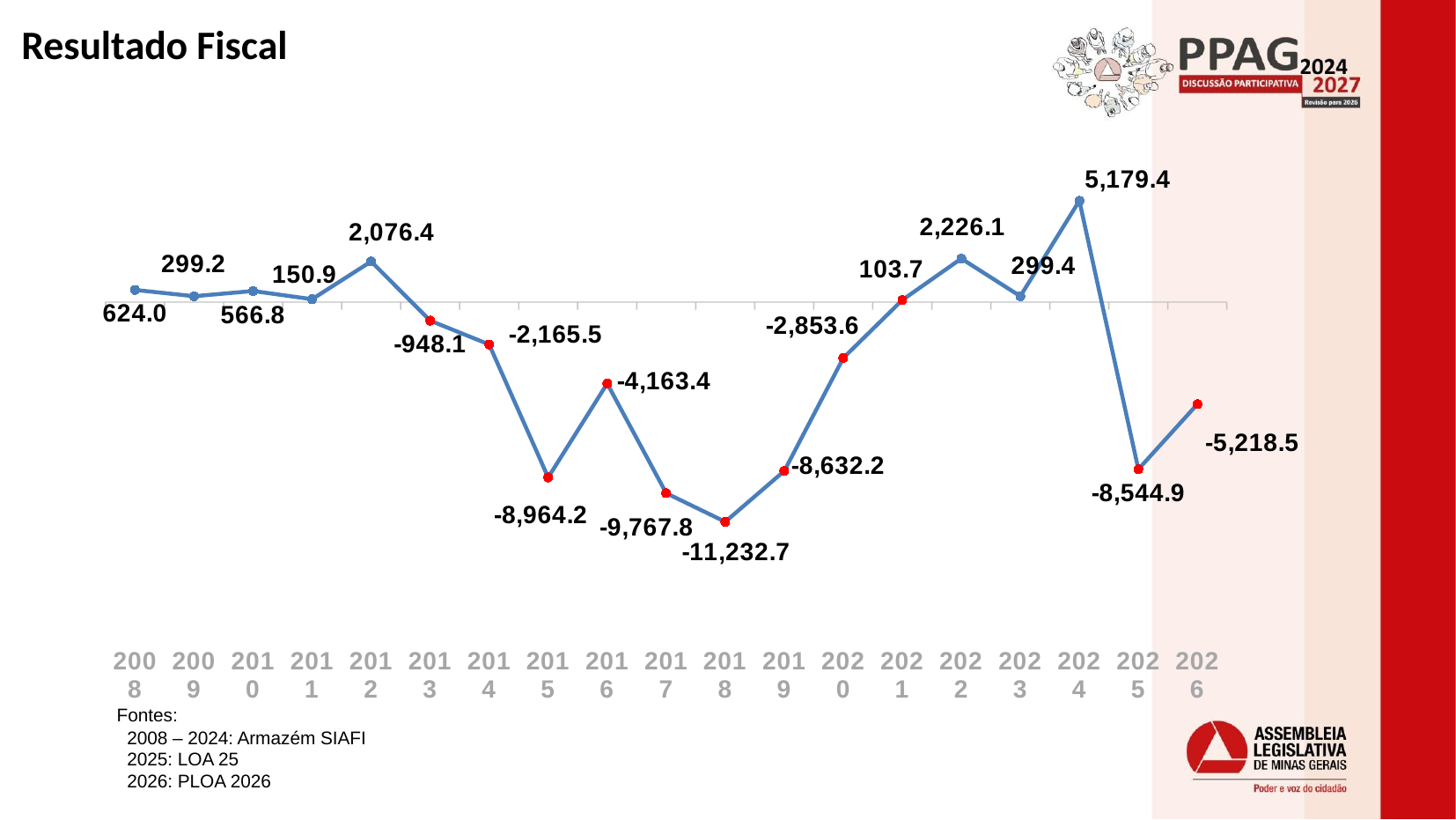
Do the values rise or fall from 2024 to 2025? Fall What kind of chart is shown on the slide? Line chart What is the value for 2024? 5,179.4 What is the value for 2026? -5,218.5 Which is larger, the value for 2025 or the value for 2026? 2026 How many years are plotted on the chart? 19 Which is larger, the value for 2008 or the value for 2010? 2008 Which year has the lowest value? 2018 What is the value for 2018? -11,232.7 What is the difference between the values for 2024 and 2022? 2,953.3 Which year has the highest value? 2024 What is the value for 2012? 2,076.4